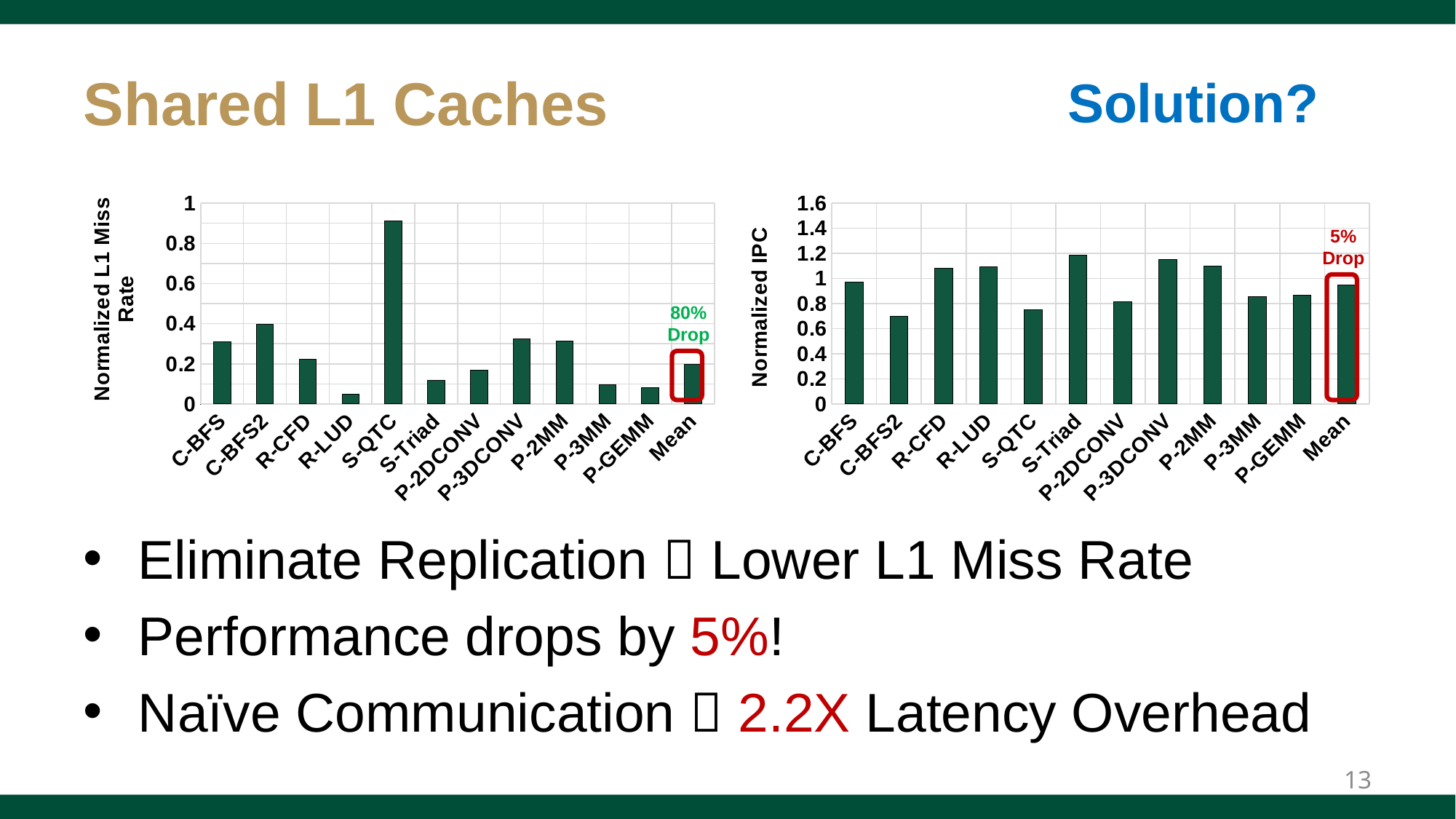
In the Normalized L1 Miss Rate chart, is the value for R-LUD greater or less than 0.2? less In the Normalized L1 Miss Rate chart, is the value for S-QTC greater or less than 0.8? greater In the Normalized L1 Miss Rate chart, which benchmark has the lowest value? R-LUD In the Normalized IPC chart on the right, is the value for C-BFS2 greater or less than 0.8? less How many benchmark categories (including Mean) are shown on the x axis of the Normalized L1 Miss Rate chart? 12 In the Normalized IPC chart, what annotation is written above the highlighted Mean bar? 5% Drop In the Normalized IPC chart, which is larger, the value for S-Triad or the value for C-BFS2? S-Triad In the Normalized L1 Miss Rate chart, what annotation is written above the highlighted Mean bar? 80% Drop What kind of chart is the Normalized L1 Miss Rate chart on the left? bar chart In the Normalized L1 Miss Rate chart, which benchmark has the highest value? S-QTC